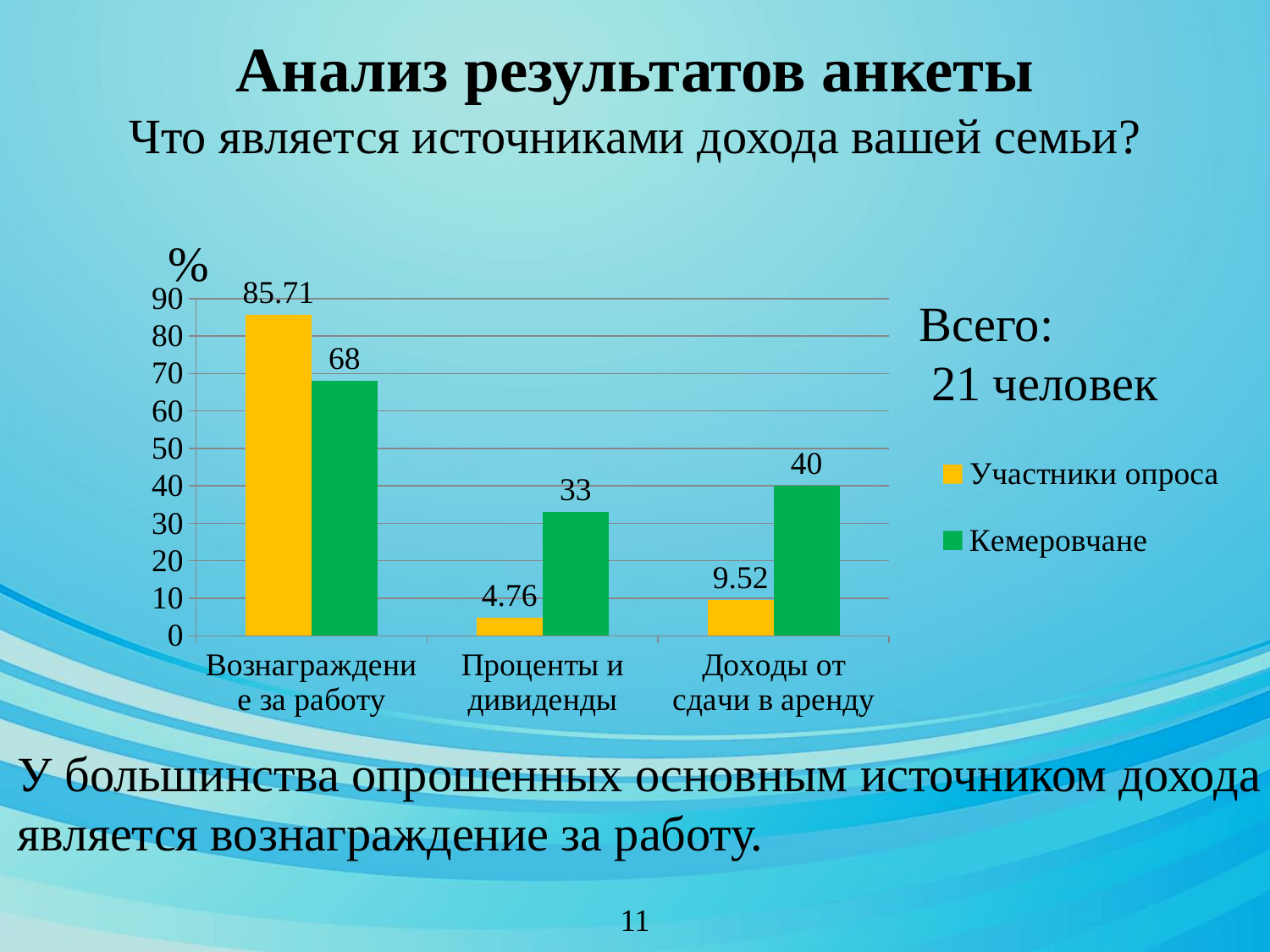
What kind of chart is shown on the slide? Bar chart What is the value for Кемеровчане in the Доходы от сдачи в аренду category? 40 What is the value for Участники опроса in the Доходы от сдачи в аренду category? 9.52 Which colour represents the Кемеровчане series? Green Which category has the highest value for Участники опроса? Вознаграждение за работу What is the value for Участники опроса in the Вознаграждение за работу category? 85.71 Which is larger in the Проценты и дивиденды category: Участники опроса or Кемеровчане? Кемеровчане What is the difference between the Участники опроса and Кемеровчане values in the Вознаграждение за работу category? 17.71 How many series does the legend list? 2 What is the value for Кемеровчане in the Проценты и дивиденды category? 33 How many categories are shown on the x axis? 3 Which category has the lowest value for Кемеровчане? Проценты и дивиденды